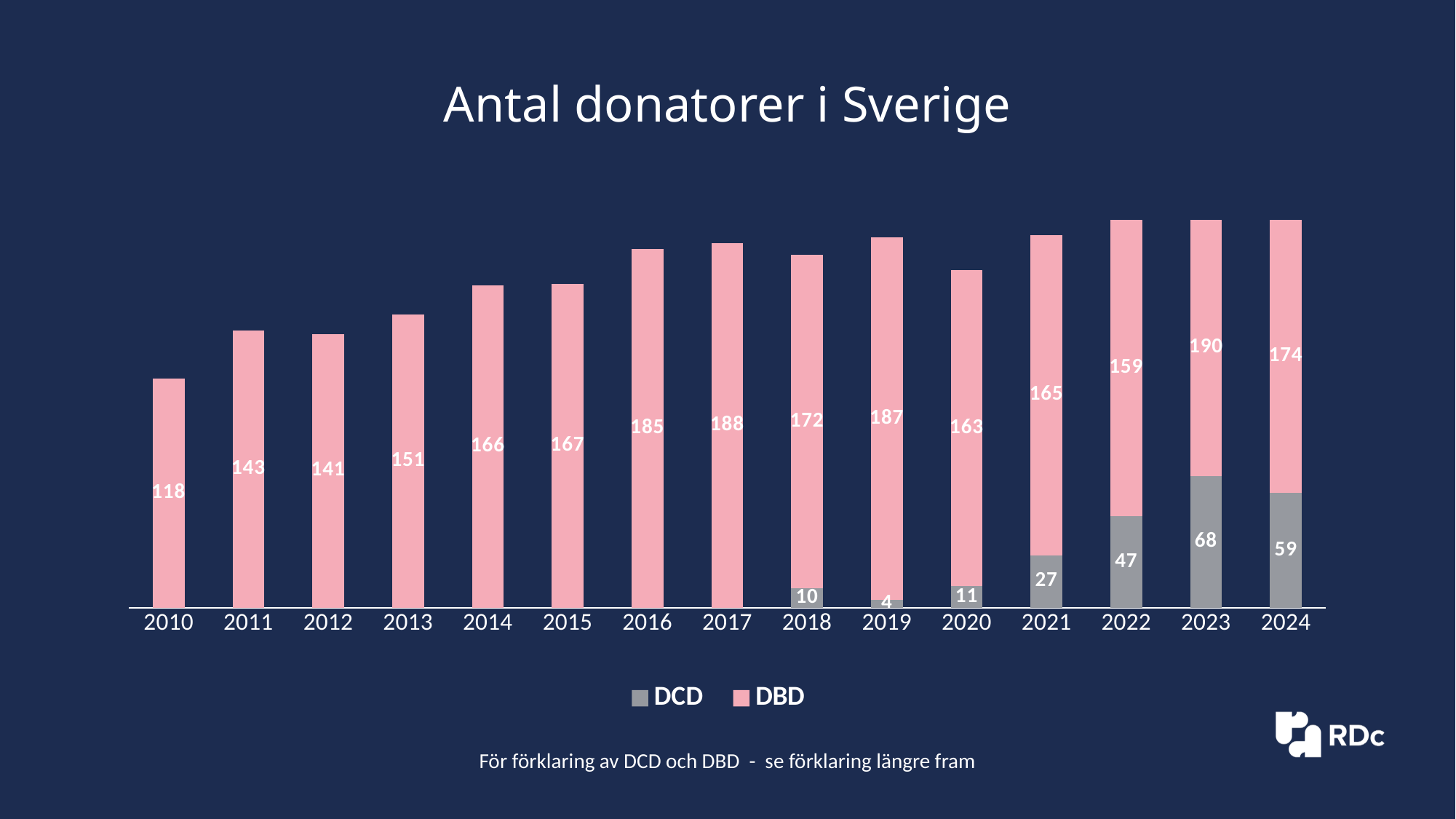
What is the total number of donors (DCD plus DBD) for 2023? 258 Which year has the lowest DCD value among the years where DCD is shown? 2019 How many years are shown on the x axis? 15 What is the DBD value for 2010? 118 Which year has the highest DBD value? 2023 How many series does the legend list? 2 What is the title of the chart? Antal donatorer i Sverige What is the DCD value for 2022? 47 What is the DBD value for 2016? 185 Which is larger, the DCD value for 2023 or the DCD value for 2024? 2023 What type of chart is shown on the slide? Stacked bar chart What is the difference between the DBD values for 2017 and 2018? 16